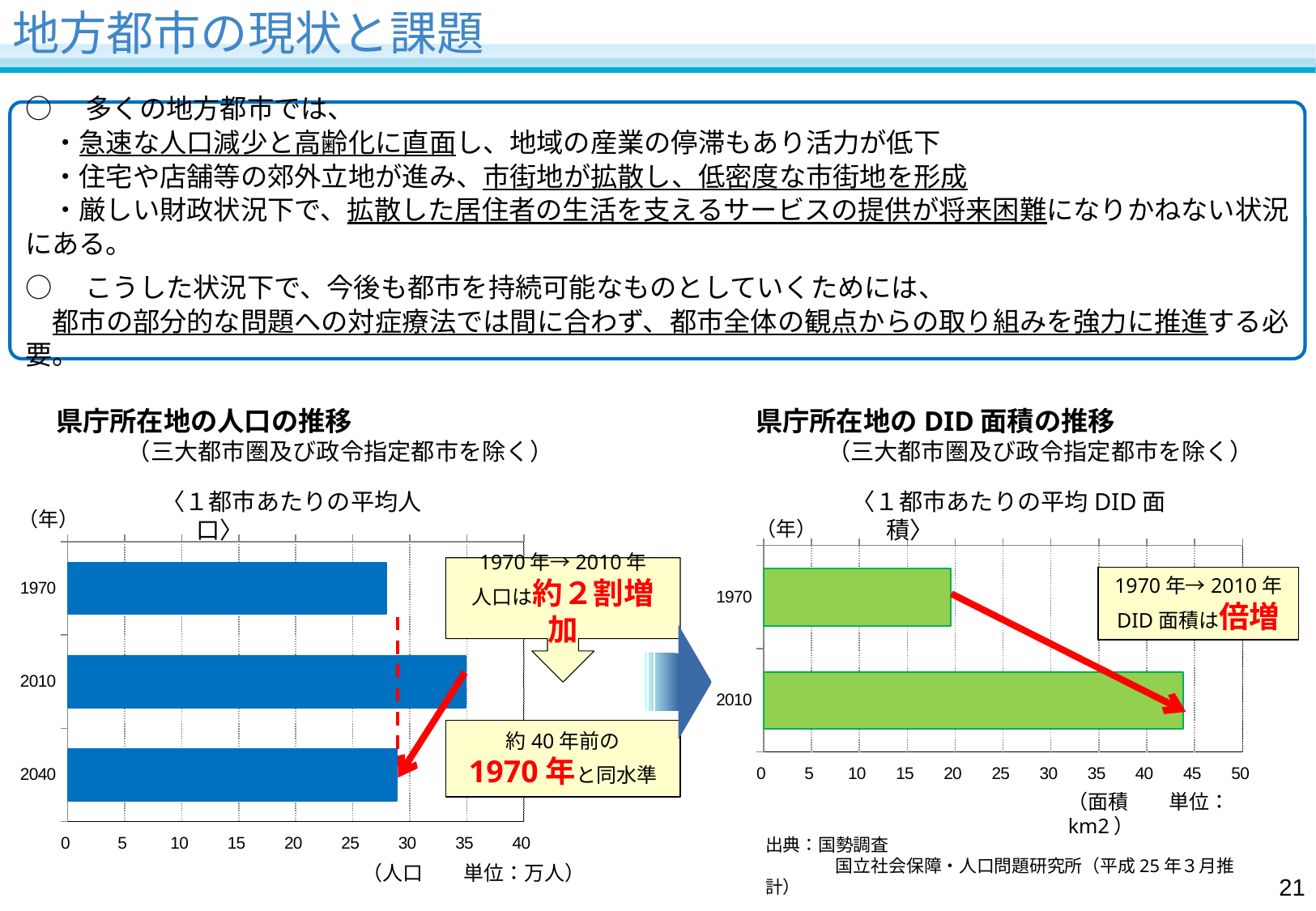
In the 県庁所在地の人口の推移 chart on the left, which year has the highest value? 2010 In the 県庁所在地のDID面積の推移 chart on the right, which year has the lowest value? 1970 What kind of chart is the 県庁所在地の人口の推移 chart on the left? bar chart In the 県庁所在地のDID面積の推移 chart on the right, does the value rise or fall from 1970 to 2010? rise What kind of chart is the 県庁所在地のDID面積の推移 chart on the right? bar chart How many years (bars) are shown in the 県庁所在地のDID面積の推移 chart on the right? 2 In the 県庁所在地の人口の推移 chart on the left, is the value for 2010 greater or less than 30? greater In the 県庁所在地のDID面積の推移 chart on the right, is the value for 2010 greater or less than 40? greater What colour are the bars in the 県庁所在地のDID面積の推移 chart on the right? green In the 県庁所在地の人口の推移 chart on the left, which is larger, the value for 1970 or the value for 2010? 2010 How many years (bars) are shown in the 県庁所在地の人口の推移 chart on the left? 3 In the 県庁所在地の人口の推移 chart on the left, is the value for 1970 greater or less than 30? less